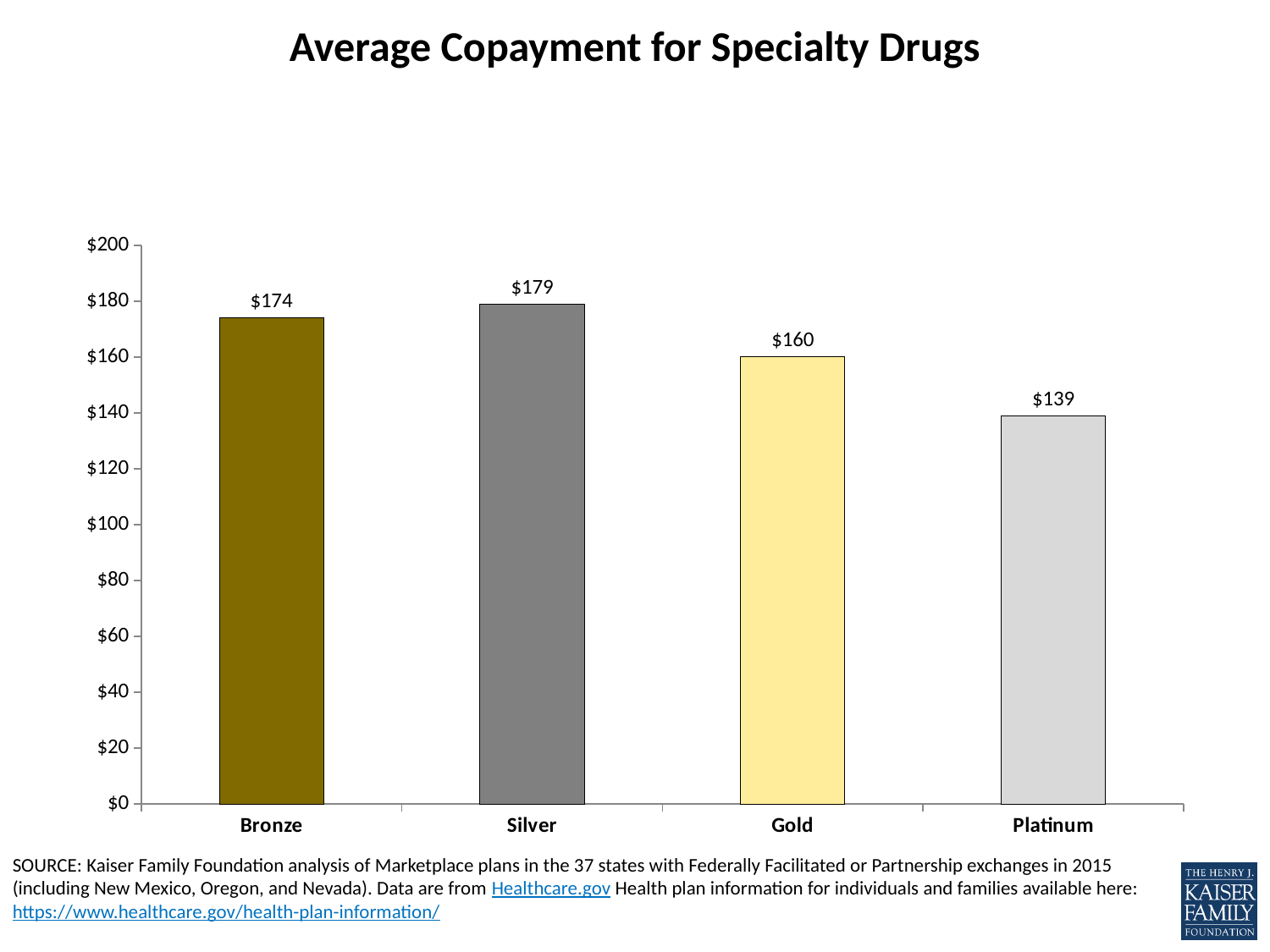
What is the average copayment for specialty drugs for Silver plans? $179 What kind of chart is shown on the slide? Bar chart How many plan types are shown in the chart? 4 Which plan type has the lowest average copayment for specialty drugs? Platinum What is the average copayment for specialty drugs for Gold plans? $160 What is the average copayment for specialty drugs for Bronze plans? $174 Which has a larger average copayment for specialty drugs, Gold or Platinum? Gold Which plan type has the highest average copayment for specialty drugs? Silver What is the average copayment for specialty drugs for Platinum plans? $139 Is the average copayment for Platinum plans greater or less than $140? less What is the difference between the average copayment for Silver and Platinum plans? $40 What is the difference between the average copayment for Bronze and Gold plans? $14